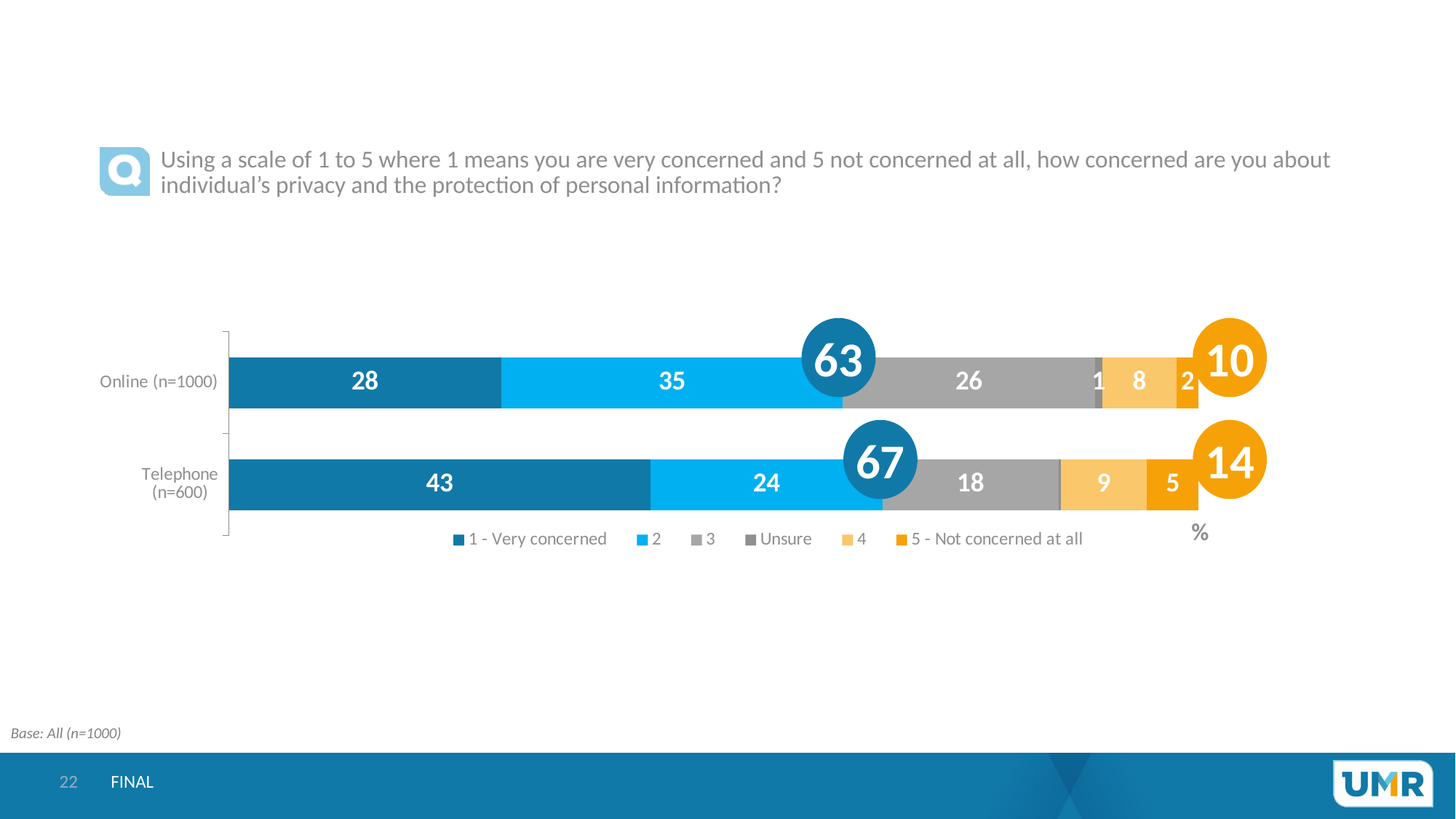
What is the value for '3' in the Online (n=1000) bar? 26 What is the value for '1 - Very concerned' in the Telephone (n=600) bar? 43 What kind of chart is shown on the slide? Stacked bar chart What is the combined value shown in the orange circle for Telephone (n=600)? 14 What is the difference between the '1 - Very concerned' values for Telephone (n=600) and Online (n=1000)? 15 What is the value for 'Unsure' in the Online (n=1000) bar? 1 How many categories are shown on the chart? 2 Which category has the higher value for '2', Online (n=1000) or Telephone (n=600)? Online (n=1000) What is the combined value shown in the blue circle for Online (n=1000)? 63 What is the value for '5 - Not concerned at all' in the Telephone (n=600) bar? 5 How many series does the legend list? 6 What is the value for '1 - Very concerned' in the Online (n=1000) bar? 28